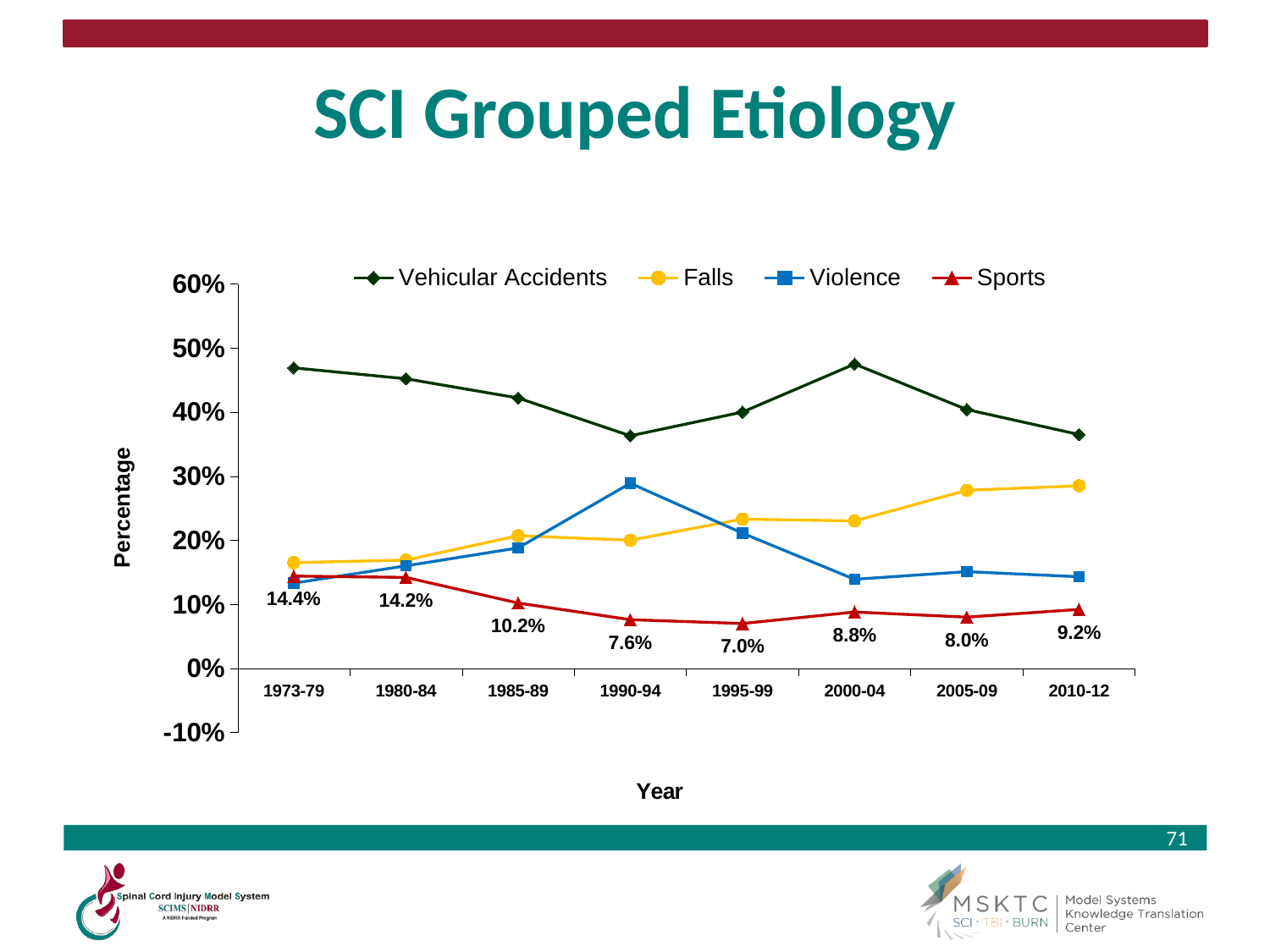
Is the value for Vehicular Accidents in 1973-79 greater or less than 40%? greater What is the value for Sports in 1995-99? 7.0% What type of chart is shown on the slide? line chart What is the value for Sports in 1973-79? 14.4% Which is larger, the Sports value for 2000-04 or for 2005-09? 2000-04 What is the value for Sports in 2010-12? 9.2% What is the difference between the Sports values for 1973-79 and 2010-12? 5.2% How many year periods are plotted along the x axis? 8 Is the value for Violence in 1990-94 greater or less than 20%? greater How many series does the legend list? 4 In which year period is the Sports value lowest? 1995-99 Which series has the highest value in 2010-12? Vehicular Accidents